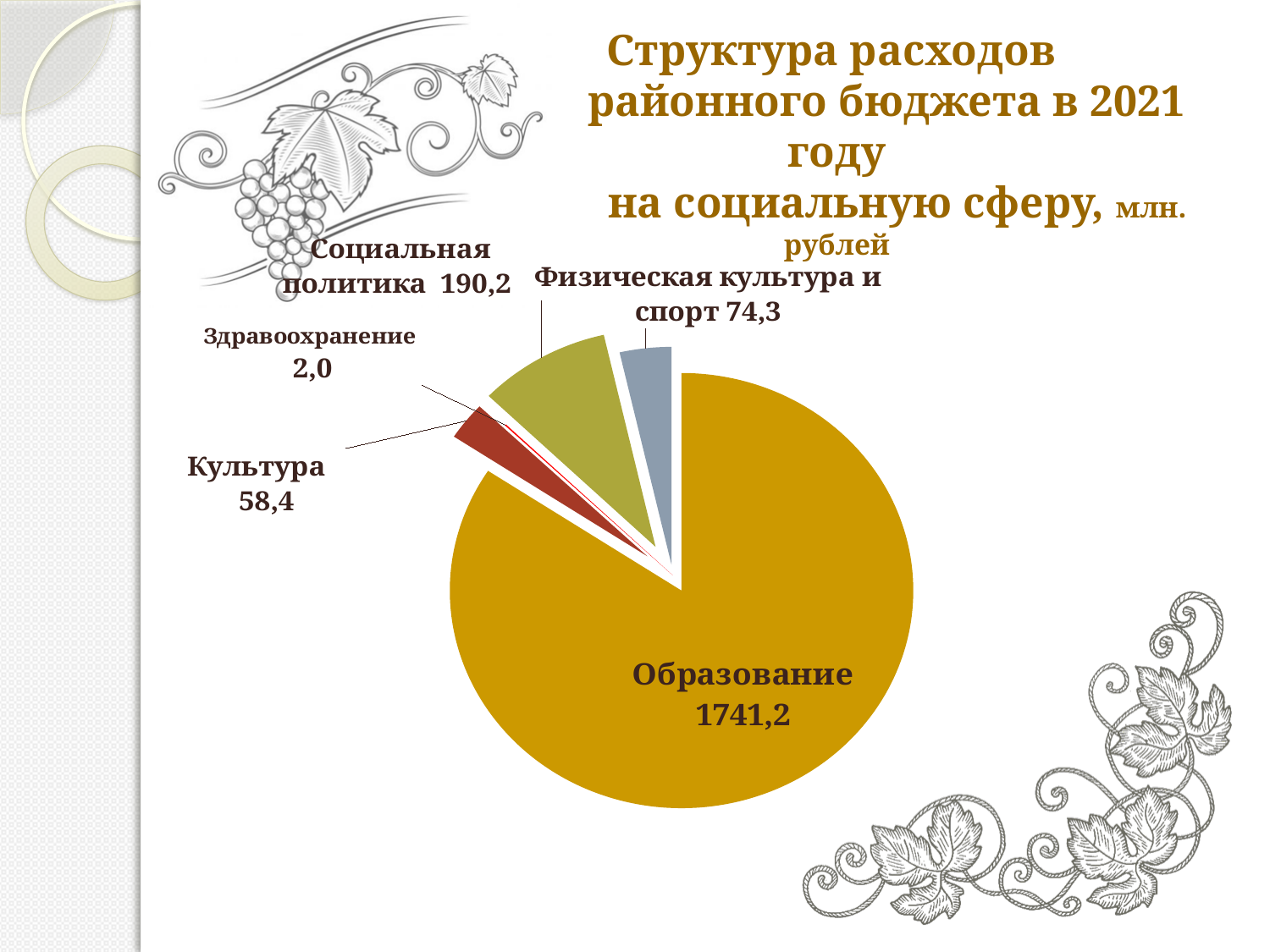
In what units are the values in the chart expressed, according to the title? млн. рублей What is the value for Образование? 1741,2 What is the value for Культура? 58,4 Which category has the smallest slice of the pie? Здравоохранение How many categories are shown in the pie chart? 5 Which category has the largest slice of the pie? Образование Which is larger, the value for Физическая культура и спорт or the value for Культура? Физическая культура и спорт What is the value for Здравоохранение? 2,0 What is the difference between the values for Социальная политика and Физическая культура и спорт? 115,9 What is the value for Социальная политика? 190,2 What type of chart is shown on the slide? Pie chart What is the value for Физическая культура и спорт? 74,3